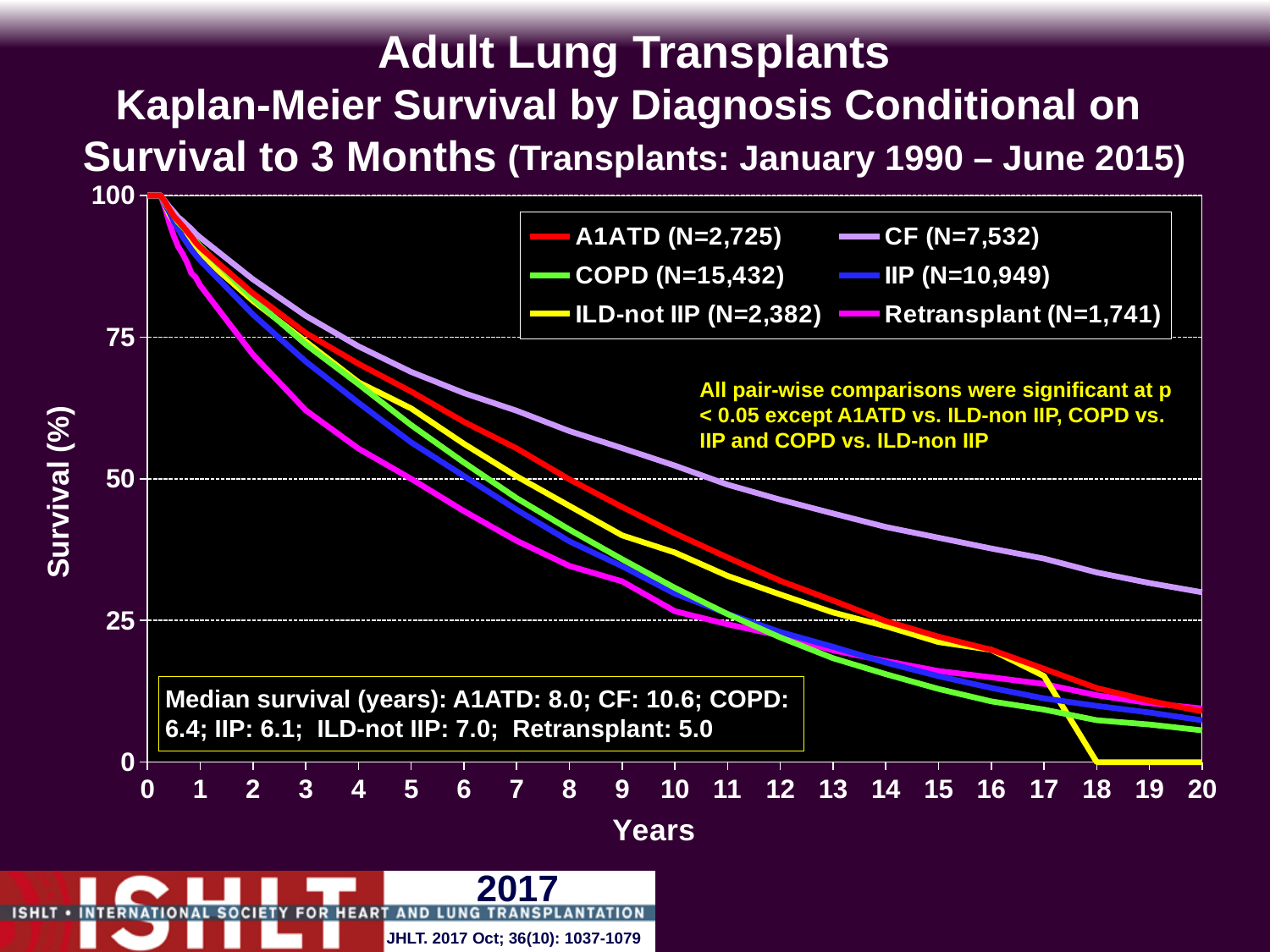
Which diagnosis group has the highest survival at 15 years? CF What is the difference in median survival (years) between CF and A1ATD? 2.6 What kind of chart is shown on the slide? Line chart What is the median survival in years for the CF group? 10.6 Do the survival curves rise or fall as years increase? Fall How many diagnosis groups (series) does the legend list? 6 Is the survival for CF at 20 years greater or less than 25%? greater Which has a longer median survival, IIP or ILD-not IIP? ILD-not IIP Which diagnosis group has the lowest median survival? Retransplant What is the median survival in years for the Retransplant group? 5.0 What is the number of patients (N) for the COPD group shown in the legend? 15,432 Which diagnosis group has the highest median survival? CF